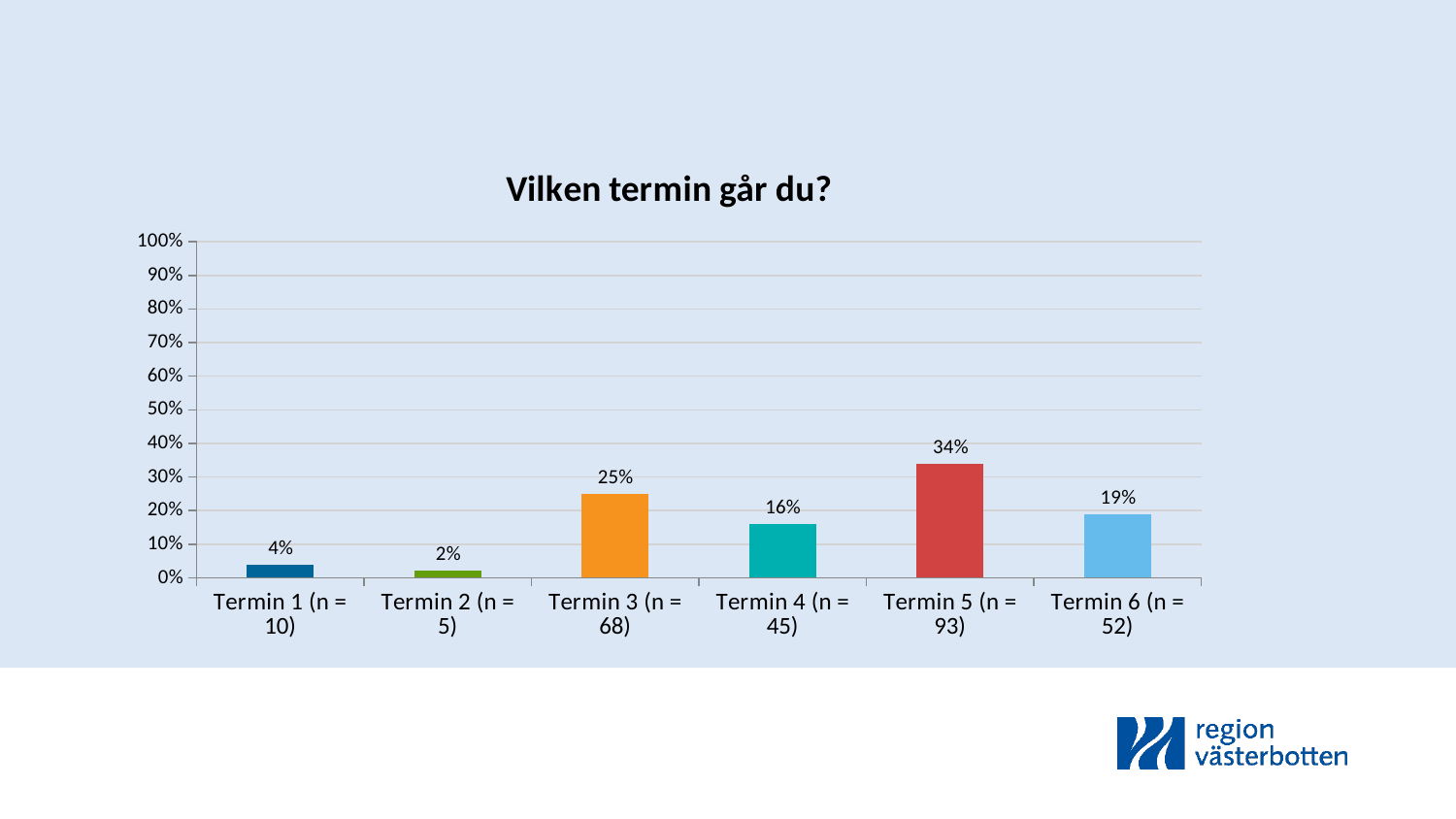
How many categories are shown on the x axis? 6 Which category has the lowest value? Termin 2 (n = 5) What is the title of the chart? Vilken termin går du? Is the value for Termin 5 (n = 93) greater or less than 30%? greater What is the difference between the values for Termin 5 (n = 93) and Termin 6 (n = 52)? 15% What is the value for Termin 5 (n = 93)? 34% What is the value for Termin 1 (n = 10)? 4% What is the value for Termin 3 (n = 68)? 25% Which is larger, the value for Termin 4 (n = 45) or Termin 6 (n = 52)? Termin 6 (n = 52) What is the difference between the values for Termin 3 (n = 68) and Termin 4 (n = 45)? 9% Which category has the highest value? Termin 5 (n = 93) What kind of chart is shown on the slide? bar chart